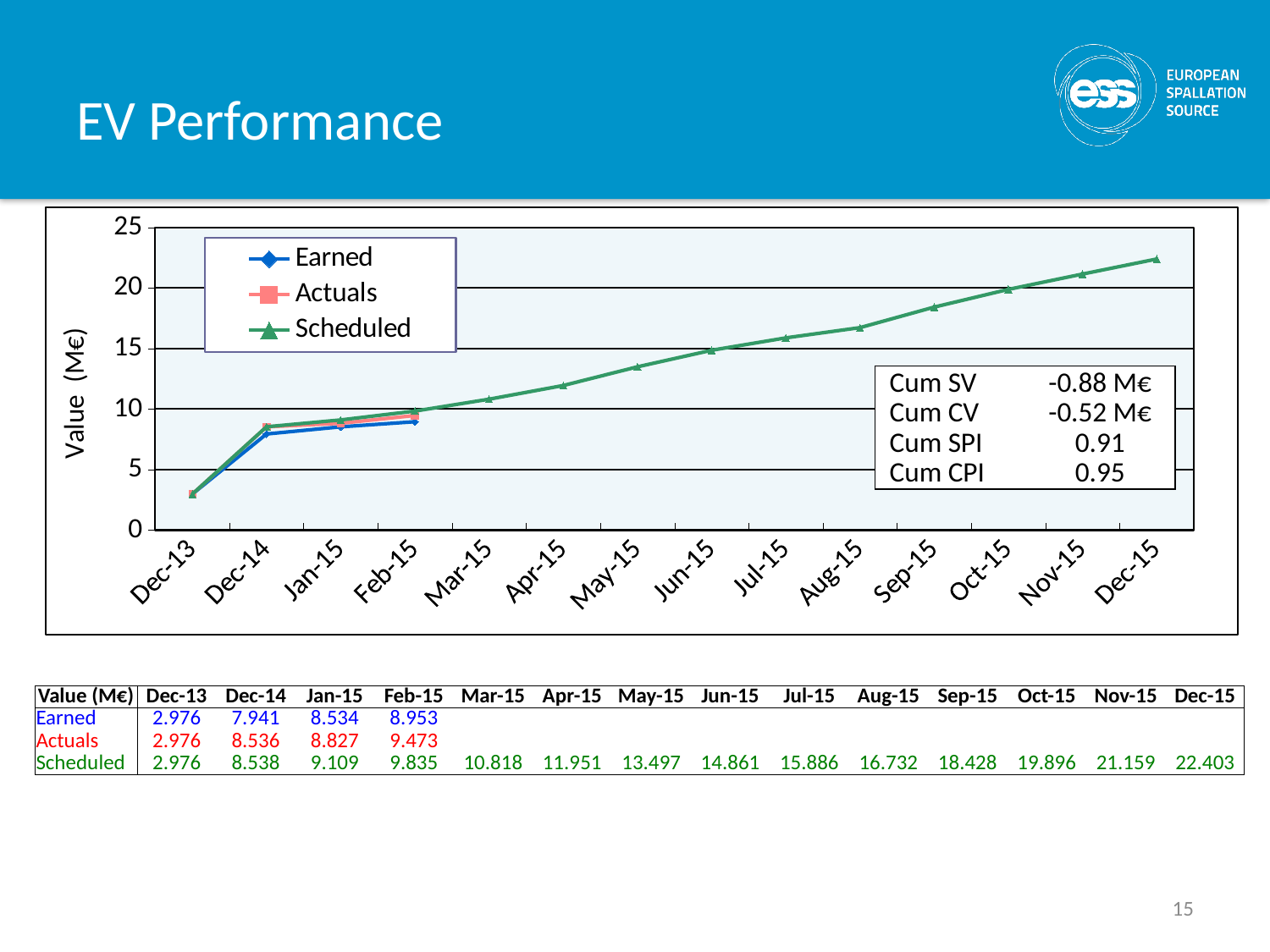
What kind of chart is shown on the slide? line chart Is the Scheduled value for Aug-15 greater or less than 15? greater What is the Earned value for Feb-15? 8.953 For Dec-14, which is larger: Actuals or Earned? Actuals Does the Scheduled series rise or fall from Dec-13 to Dec-15? rise What is the Actuals value for Jan-15? 8.827 What Cum SV value is shown in the box on the chart? -0.88 M€ How many series does the chart legend list? 3 What is the Scheduled value for Dec-15? 22.403 What is the difference between the Scheduled and Earned values for Feb-15? 0.882 How many months are shown along the x axis of the chart? 14 What is the difference between the Actuals and Earned values for Feb-15? 0.520